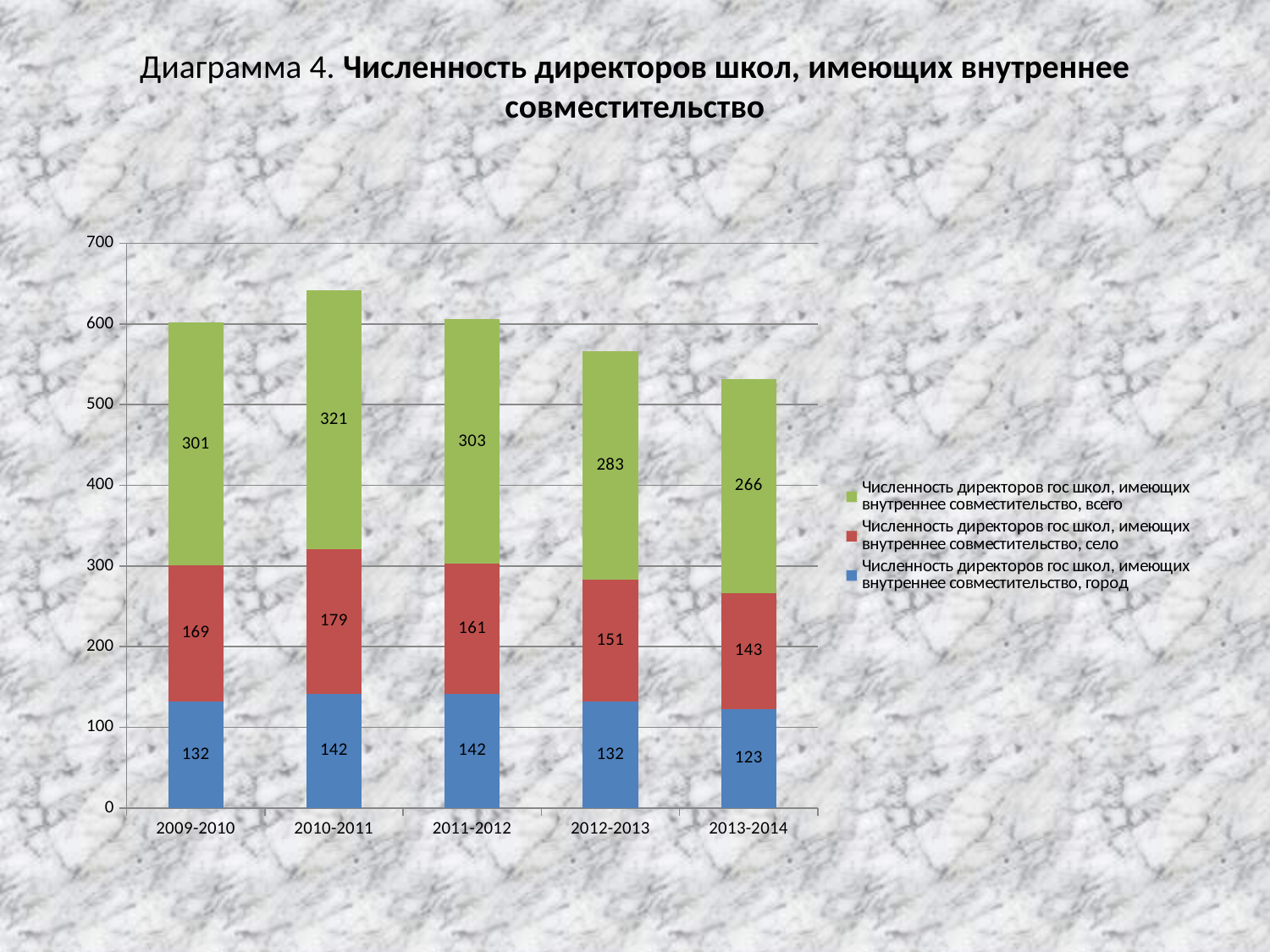
In which school year is the 'всего' (green) segment the highest? 2010-2011 Which is larger: the 'село' (red) value for 2011-2012 or for 2012-2013? 2011-2012 In which school year is the 'село' (red) segment the lowest? 2013-2014 How many series does the legend list? 3 How many school-year categories are shown on the x axis? 5 What is the difference between the 'всего' (green) values for 2010-2011 and 2013-2014? 55 What type of chart is shown on the slide? stacked bar chart From 2010-2011 to 2013-2014, do the 'всего' (green) values rise or fall? fall What is the total height of the stacked bar for 2009-2010? 602 What is the value of the 'город' (blue) segment for 2013-2014? 123 What is the value of the 'село' (red) segment for 2010-2011? 179 What is the value of the 'всего' (green) segment for 2012-2013? 283